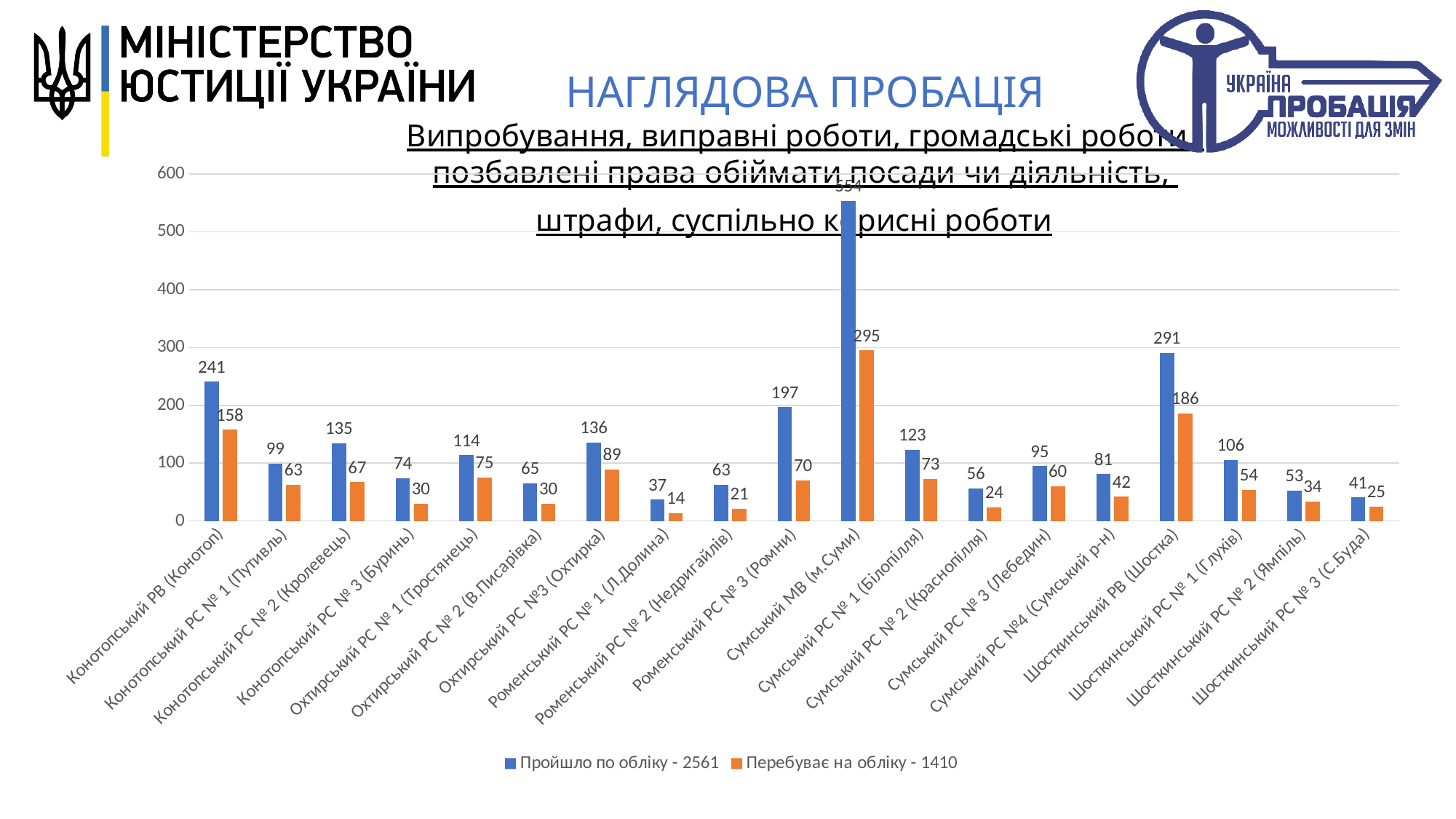
How many categories are shown on the x axis? 19 What is the difference between 'Пройшло по обліку' and 'Перебуває на обліку' for Роменський РС № 3 (Ромни)? 127 What is the value of 'Перебуває на обліку' for Сумський МВ (м.Суми)? 295 Which category has the highest value for 'Пройшло по обліку'? Сумський МВ (м.Суми) Which category has the lowest value for 'Перебуває на обліку'? Роменський РС № 1 (Л.Долина) What is the value of 'Пройшло по обліку' for Конотопський РВ (Конотоп)? 241 How many series does the legend list? 2 Is the value of 'Пройшло по обліку' for Шосткинський РВ (Шостка) greater or less than 200? greater What type of chart is shown on the slide? bar chart What is the value of 'Перебуває на обліку' for Шосткинський РВ (Шостка)? 186 What total is given in the legend entry for 'Перебуває на обліку'? 1410 Which is larger: 'Пройшло по обліку' for Охтирський РС №3 (Охтирка) or for Конотопський РС № 2 (Кролевець)? Охтирський РС №3 (Охтирка)